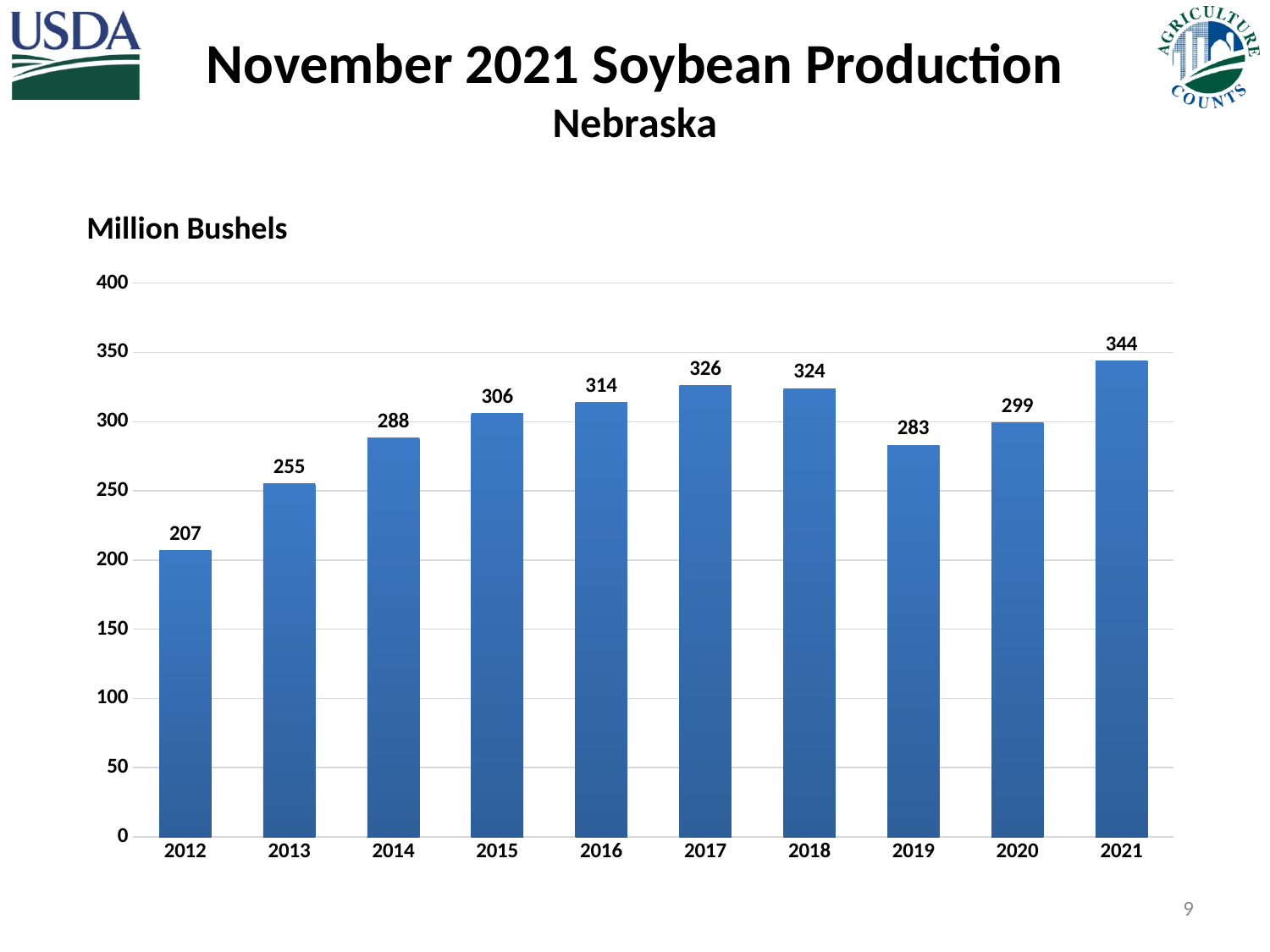
What was Nebraska's soybean production in 2021, in million bushels? 344 What is the difference in soybean production between 2017 and 2012, in million bushels? 119 Which year had the lowest soybean production? 2012 What is the difference in soybean production between 2021 and 2020, in million bushels? 45 What kind of chart is shown on the slide? Bar chart Which year had higher soybean production, 2014 or 2019? 2014 What was Nebraska's soybean production in 2019, in million bushels? 283 What unit is the chart's y axis measured in? Million Bushels How many years are shown on the chart? 10 What was Nebraska's soybean production in 2012, in million bushels? 207 Which year had the highest soybean production? 2021 Which year had higher soybean production, 2017 or 2018? 2017